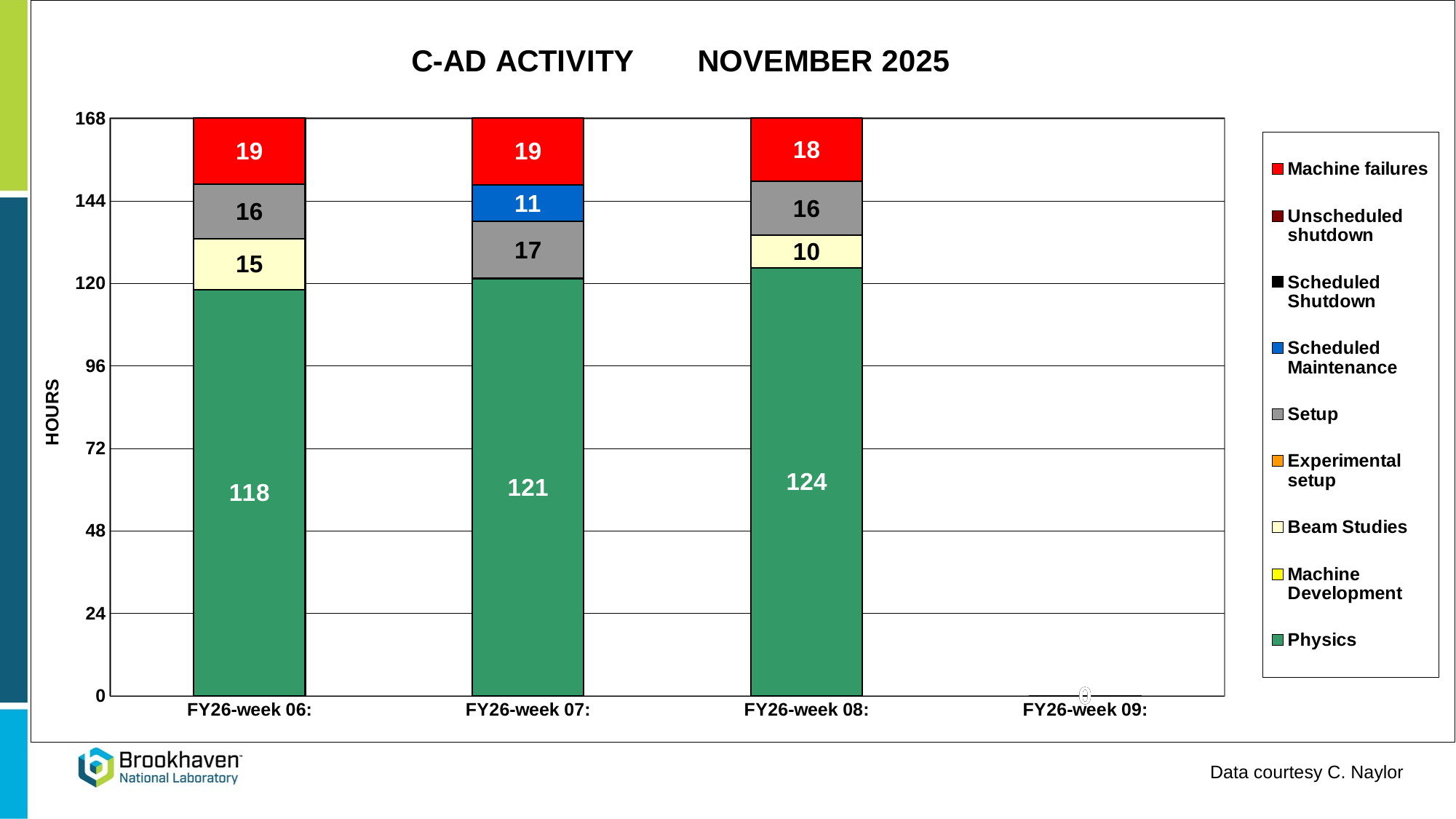
Which week has the highest Physics hours? FY26-week 08 How many hours of Machine failures are shown for FY26-week 08? 18 What kind of chart is shown on the slide? Stacked bar chart How many series does the legend list? 9 What is the difference in Physics hours between FY26-week 08 and FY26-week 06? 6 Which is larger, the Setup hours in FY26-week 07 or in FY26-week 08? FY26-week 07 Which week has the lowest Physics hours? FY26-week 06 How many hours of Beam Studies are shown for FY26-week 06? 15 How many hours of Physics are shown for FY26-week 07? 121 How many hours of Scheduled Maintenance are shown for FY26-week 07? 11 What is the total of the stacked bar for FY26-week 06? 168 Do the Physics hours rise or fall from FY26-week 06 to FY26-week 08? Rise